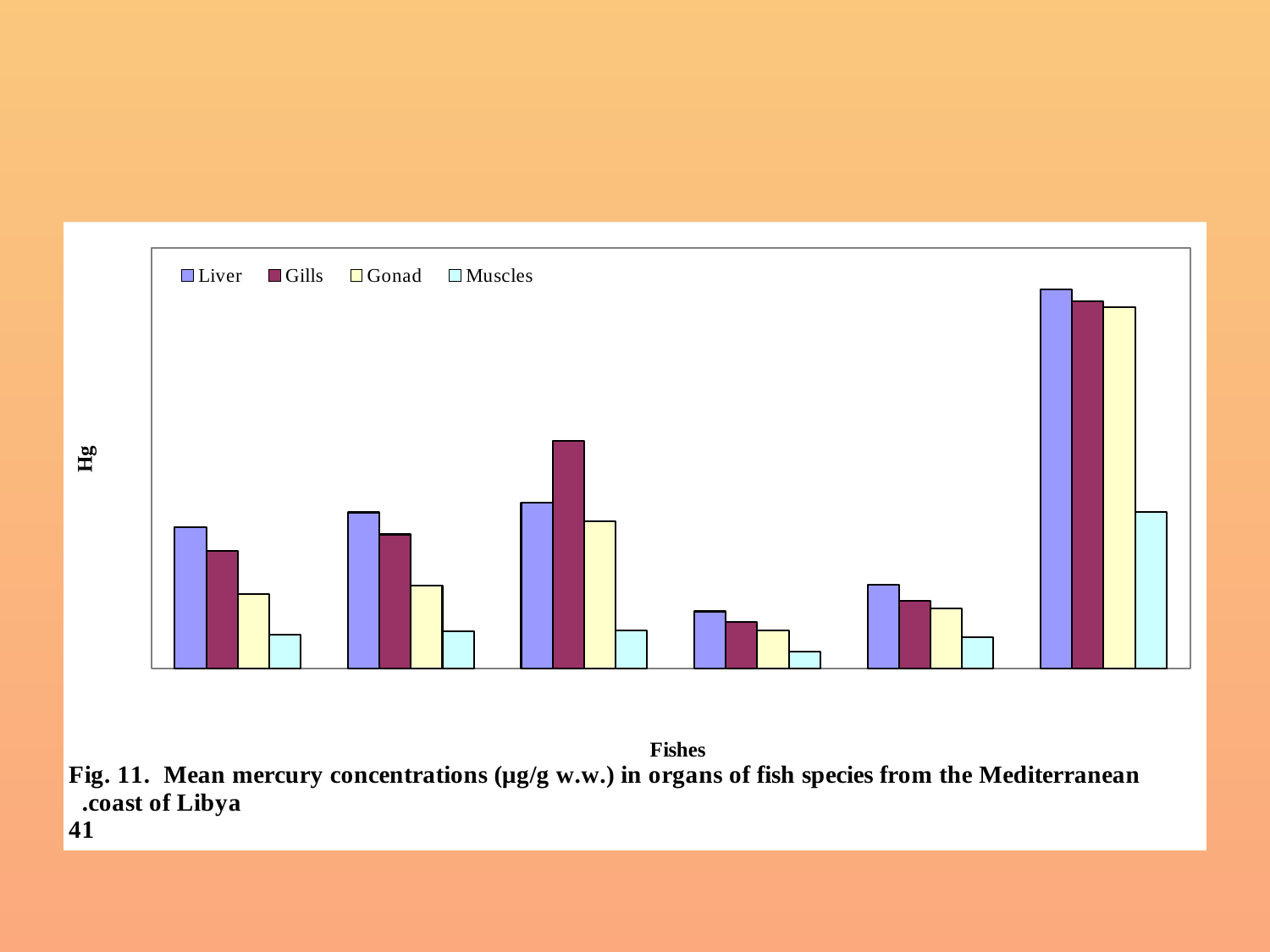
What is the label on the vertical axis of the chart? Hg In the fourth group of bars from the left, which series has the lowest bar? Muscles What are the series listed in the legend? Liver, Gills, Gonad, Muscles In the third group of bars from the left, which series has the tallest bar? Gills How many groups of bars (fish species) are plotted on the chart? 6 What kind of chart is shown on the slide? bar chart In the rightmost group of bars, which series has the lowest bar? Muscles Which group of bars, counting from the left, has the tallest bars overall? the sixth (rightmost) group How many series does the legend list? 4 In the leftmost group of bars, which is larger, the Liver bar or the Gonad bar? Liver